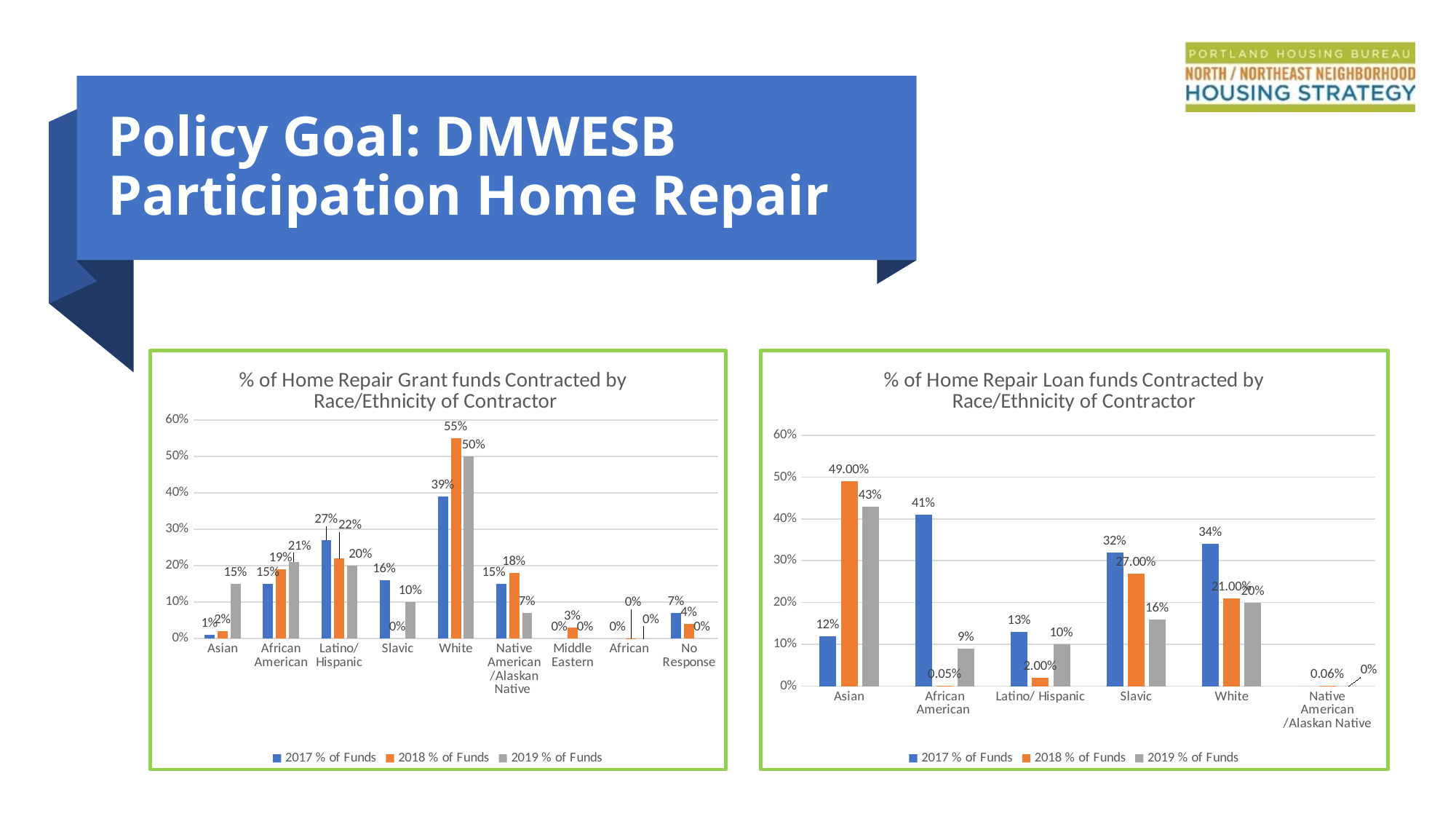
In the Home Repair Loan funds chart, what is the difference between the 2017 and 2019 % of Funds values for Slavic? 16% In the Home Repair Loan funds chart, what is the 2018 % of Funds value for Asian? 49.00% In the Home Repair Grant funds chart, what is the 2019 % of Funds value for Asian? 15% How many series does the legend of the Home Repair Loan funds chart list? 3 In the Home Repair Grant funds chart, what is the 2018 % of Funds value for White? 55% In the Home Repair Loan funds chart, what is the 2017 % of Funds value for African American? 41% In the Home Repair Loan funds chart, is the 2017 % of Funds value for Slavic larger or smaller than the 2017 value for White? smaller How many categories are shown on the x axis of the Home Repair Grant funds chart? 9 In the Home Repair Grant funds chart, which category has the highest 2017 % of Funds value? White In the Home Repair Grant funds chart, what is the difference between the 2017 and 2018 % of Funds values for Latino/Hispanic? 5% In the Home Repair Loan funds chart, which category has the highest 2019 % of Funds value? Asian What type of chart is the Home Repair Grant funds chart? bar chart